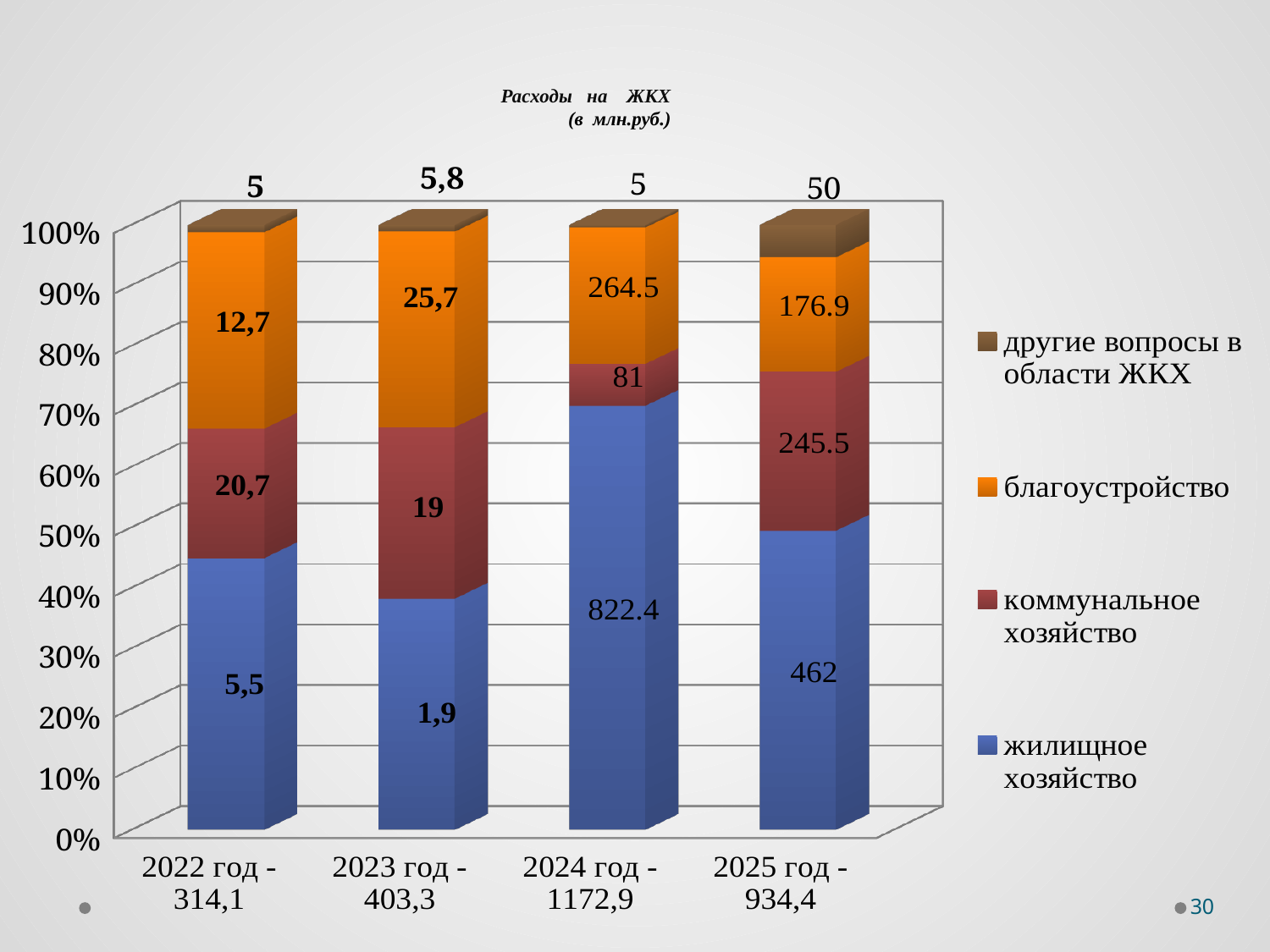
What is the data label for благоустройство in the 2025 год bar? 176.9 How many year categories are shown on the x axis of the chart? 4 Which year has the larger data label for жилищное хозяйство, 2024 год or 2025 год? 2024 год What is the data label for жилищное хозяйство in the 2024 год bar? 822.4 What is the data label for другие вопросы в области ЖКХ in the 2025 год bar? 50 What is the data label for благоустройство in the 2022 год bar? 12,7 What is the data label for коммунальное хозяйство in the 2023 год bar? 19 What is the title of the chart? Расходы на ЖКХ (в млн.руб.) In the 2024 год bar, is the share of жилищное хозяйство greater or less than 50%? greater How many series does the chart legend list? 4 What kind of chart is shown on the slide? Stacked bar chart What is the difference between the коммунальное хозяйство labels for 2025 год (245.5) and 2024 год (81)? 164.5